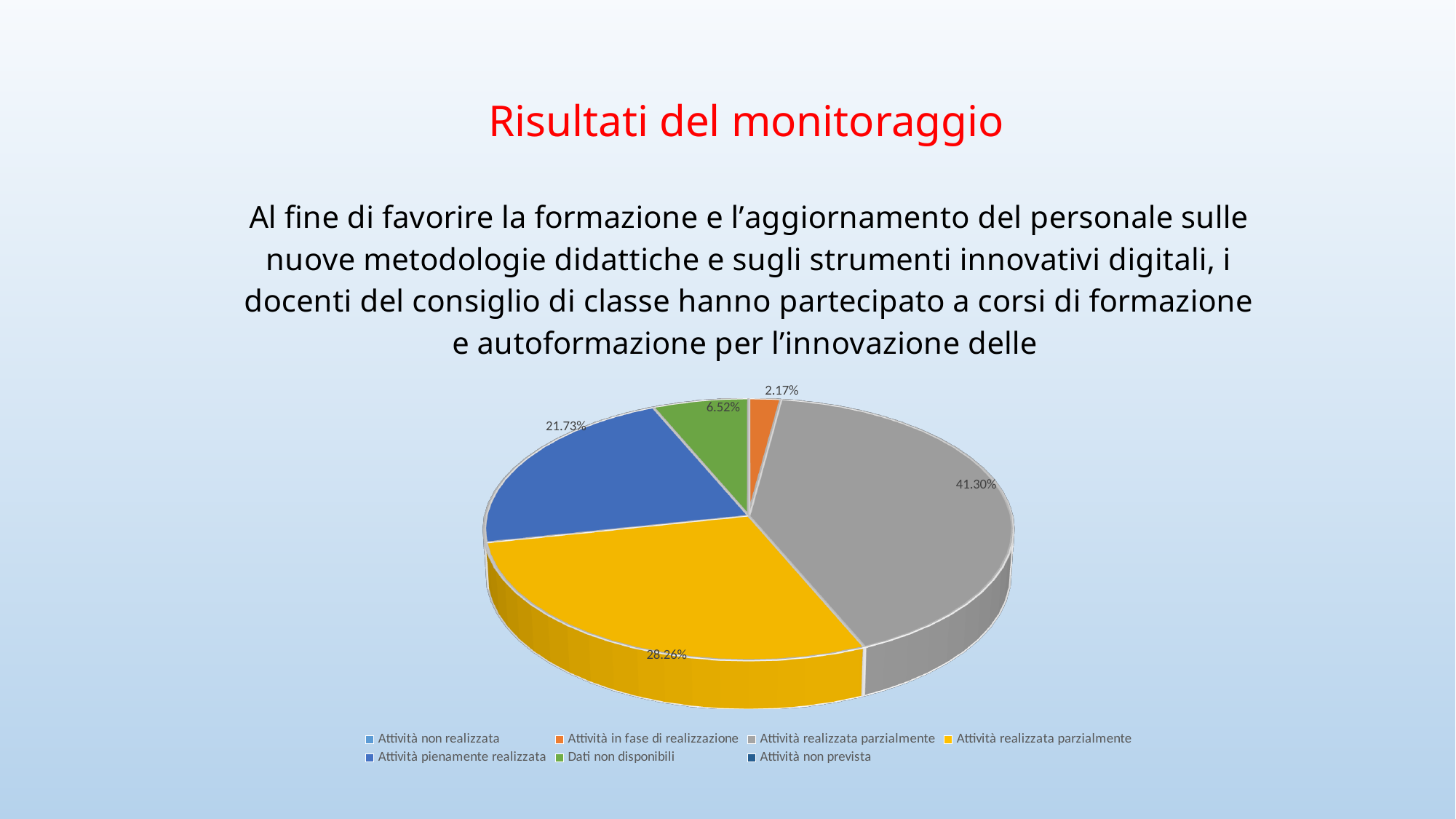
What is the largest percentage shown on the pie chart? 41.30% Which category has the smallest slice of the pie chart? Attività in fase di realizzazione What percentage is shown for "Attività in fase di realizzazione"? 2.17% How many entries does the legend list? 7 Which is larger: the slice for "Attività pienamente realizzata" or the slice for "Dati non disponibili"? Attività pienamente realizzata What is the difference in percentage points between "Attività pienamente realizzata" (21.73%) and "Dati non disponibili" (6.52%)? 15.21 What is the difference in percentage points between the grey slice (41.30%) and the yellow slice (28.26%)? 13.04 What percentage is shown for "Dati non disponibili"? 6.52% What colour is the slice for "Dati non disponibili"? Green What percentage is shown for "Attività pienamente realizzata"? 21.73% How many slices are visible in the pie chart? 5 What kind of chart is shown on the slide? Pie chart